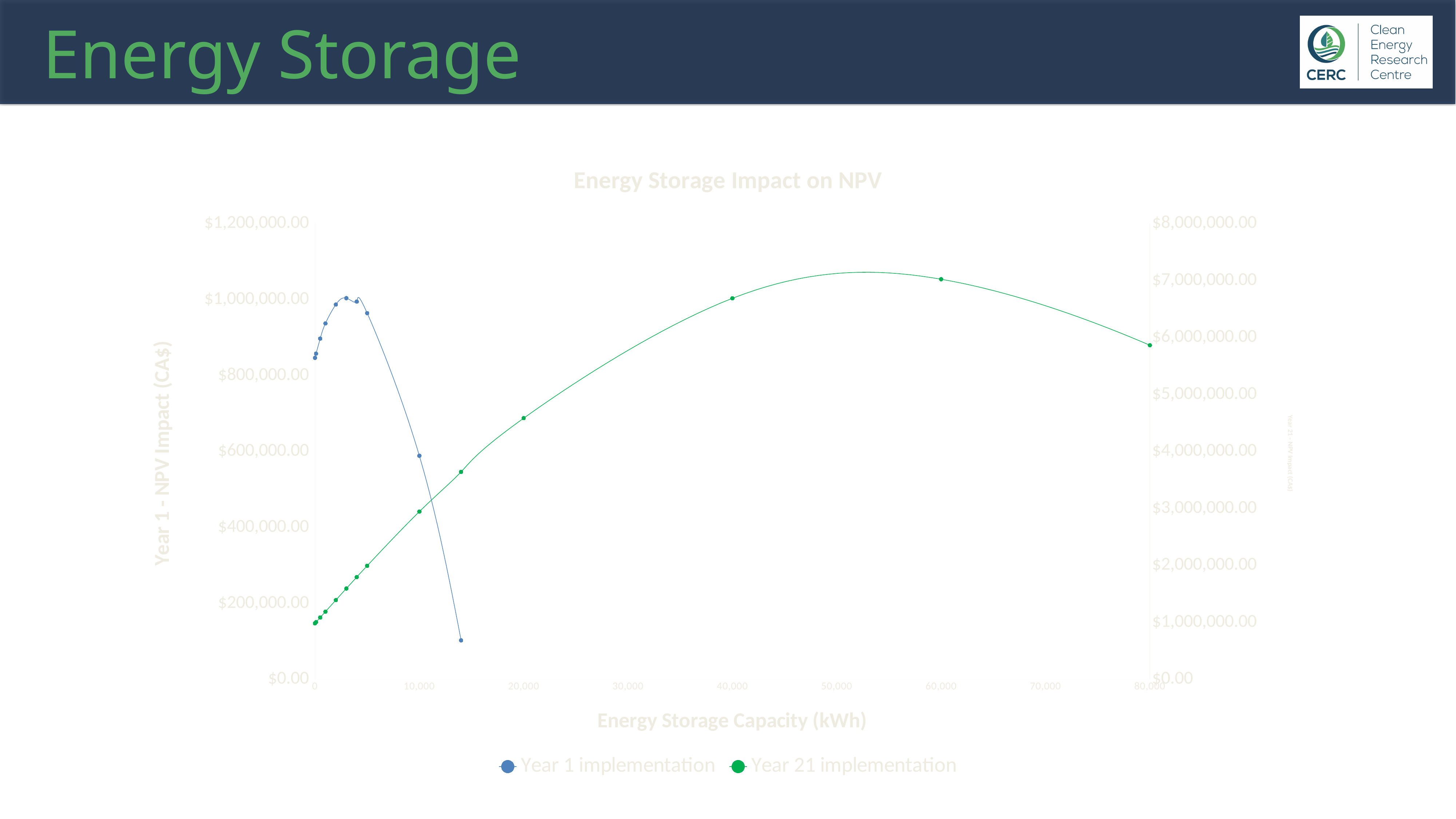
Is the Year 1 implementation value at its last plotted point (around 14,000 kWh) greater or less than $200,000.00 on the left axis? less What is the label of the x axis? Energy Storage Capacity (kWh) What kind of chart is shown on the slide? line chart Does the Year 1 implementation series rise or fall as capacity increases beyond about 5,000 kWh? fall What is the largest value shown on the x axis? 80,000 What is the highest tick value shown on the left-hand y axis? $1,200,000.00 Does the Year 21 implementation series rise or fall as capacity increases from 0 to 40,000 kWh? rise What is the title of the chart? Energy Storage Impact on NPV What is the highest tick value shown on the right-hand y axis? $8,000,000.00 Is the Year 21 implementation value at 40,000 kWh greater or less than $6,000,000.00 on the right axis? greater How many series does the chart legend list? 2 What are the two series named in the legend? Year 1 implementation and Year 21 implementation